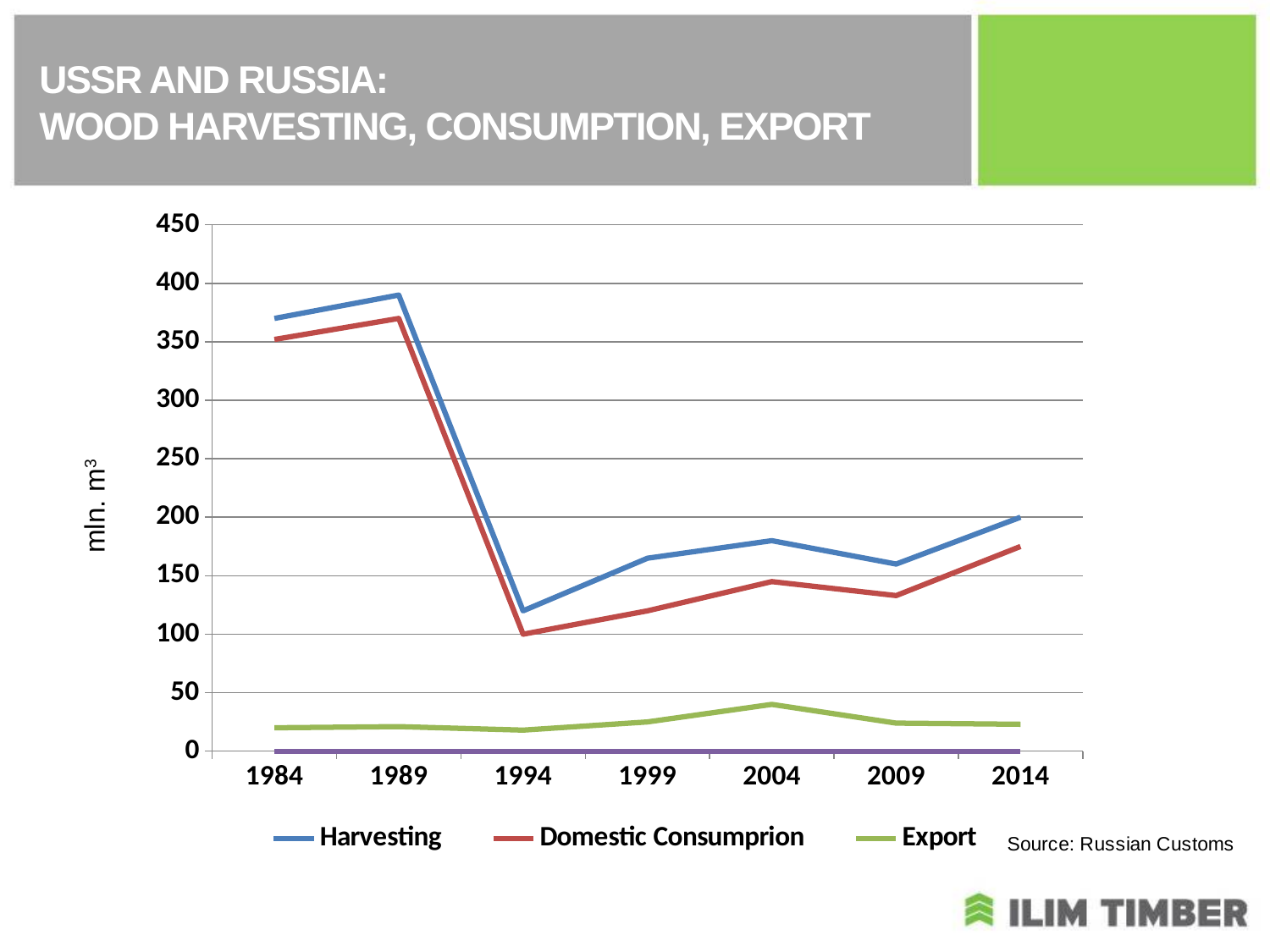
Is the Harvesting value for 1984 greater or less than 350? greater In which year is the Export value highest? 2004 How many series does the legend list? 3 What unit is shown on the y axis? mln. m³ Is the Export value for 2004 greater or less than 50? less In 2014, which is larger: Harvesting or Domestic Consumprion? Harvesting Is the Domestic Consumprion value for 1994 greater or less than 150? less Does the Harvesting line rise or fall between 1989 and 1994? Fall In which year is the Harvesting value highest? 1989 In which year is the Harvesting value lowest? 1994 How many years are shown on the x axis? 7 What kind of chart is shown on the slide? Line chart